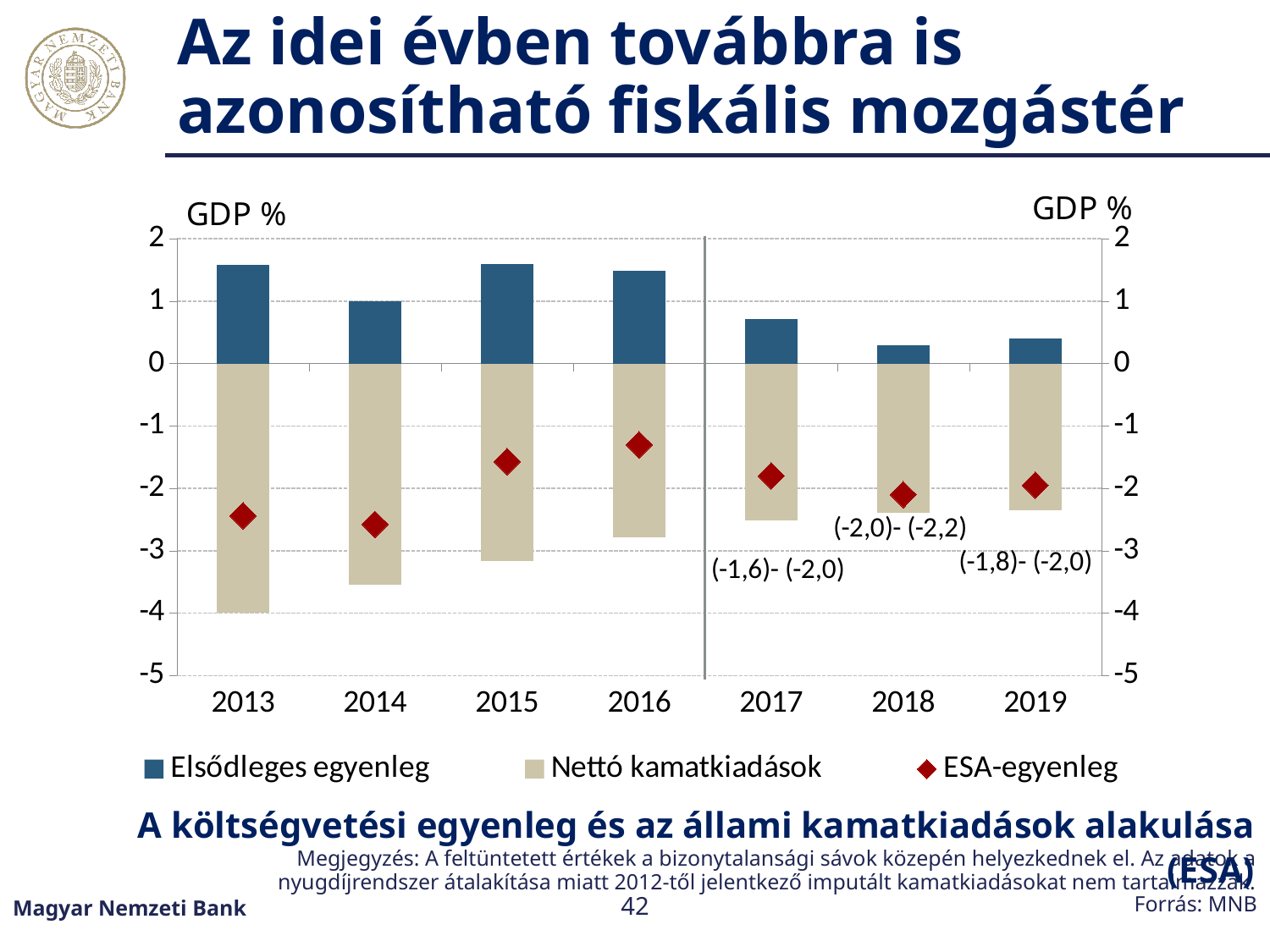
In which year is the ESA-egyenleg marker the highest? 2016 How many years are shown on the x axis of the chart? 7 Is the Elsődleges egyenleg value for 2017 greater or less than 1? less Which year has the larger Elsődleges egyenleg value, 2014 or 2017? 2014 What kind of chart is used to show Elsődleges egyenleg and Nettó kamatkiadások? bar chart Is the Elsődleges egyenleg value for 2013 greater or less than 1? greater Is the ESA-egyenleg value for 2016 greater or less than -2? greater In which year is the Nettó kamatkiadások bar the lowest (most negative)? 2013 What range is annotated next to the 2017 bar? (-1,6)- (-2,0) How many series does the chart legend list? 3 Does the Elsődleges egyenleg value rise or fall from 2016 to 2018? fall